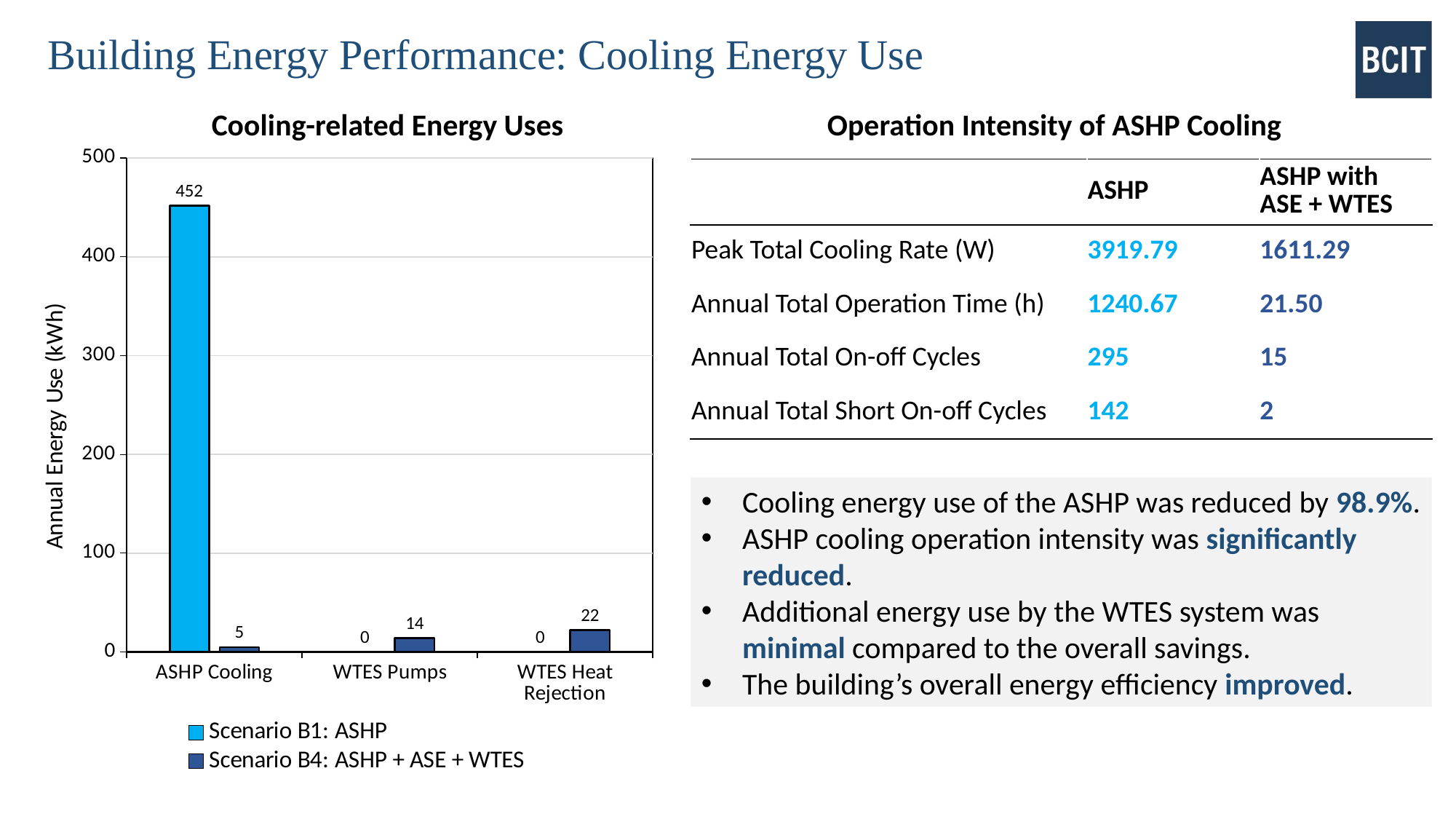
Which category has the lowest value for Scenario B4: ASHP + ASE + WTES? ASHP Cooling How many categories are shown on the x axis of the chart? 3 What is the title of the chart? Cooling-related Energy Uses Which category has the highest value for Scenario B4: ASHP + ASE + WTES? WTES Heat Rejection What is the Annual Energy Use for WTES Pumps under Scenario B4: ASHP + ASE + WTES? 14 What is the Annual Energy Use for ASHP Cooling under Scenario B4: ASHP + ASE + WTES? 5 How many series does the chart legend list? 2 What is the Annual Energy Use for WTES Heat Rejection under Scenario B4: ASHP + ASE + WTES? 22 What is the Annual Energy Use for ASHP Cooling under Scenario B1: ASHP? 452 What is the difference between the ASHP Cooling values for Scenario B1 and Scenario B4? 447 Which is larger: the Scenario B4 value for WTES Pumps or for WTES Heat Rejection? WTES Heat Rejection What kind of chart is shown on the slide? Bar chart